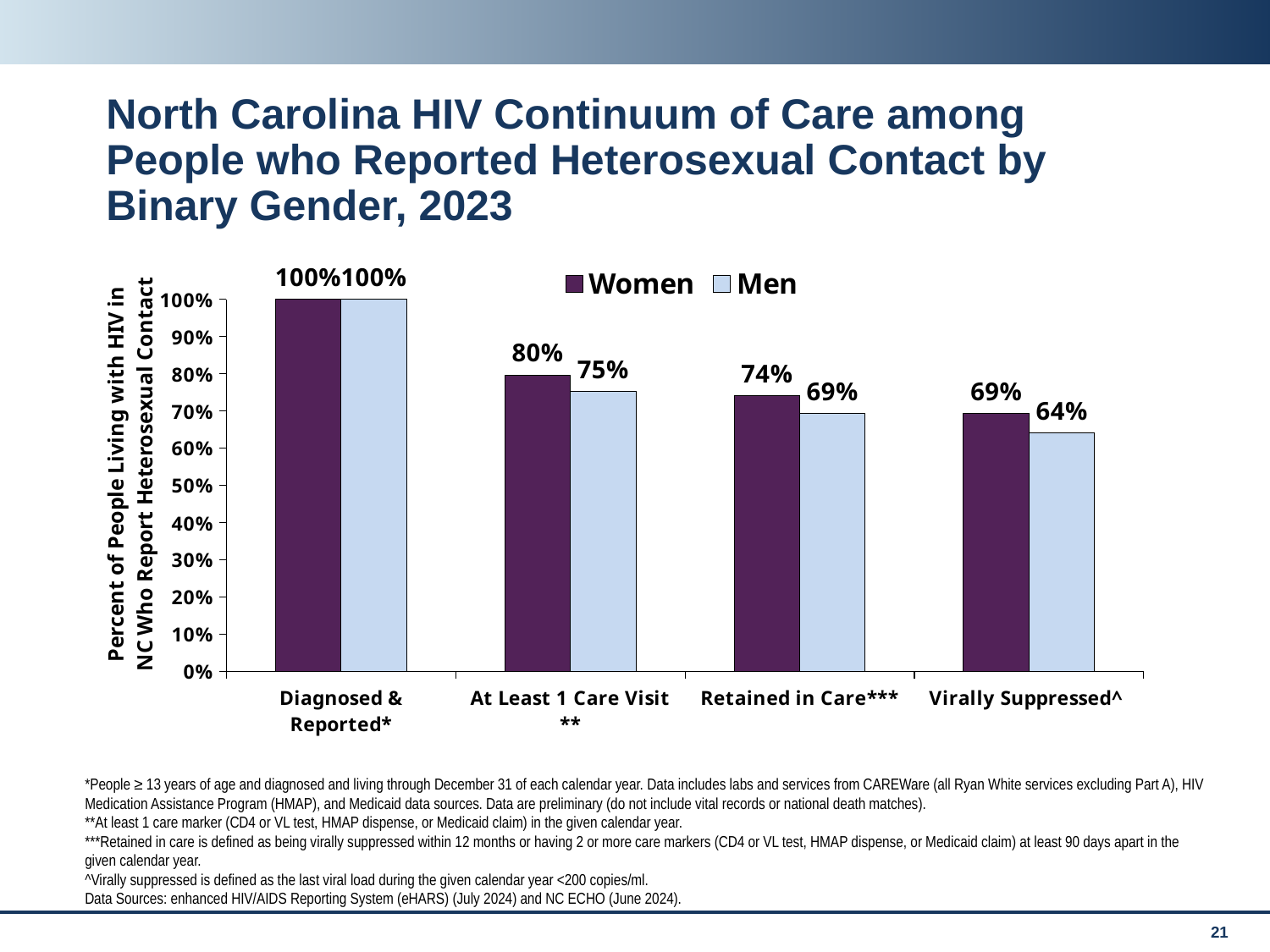
Do the values for Men rise or fall from left to right across the categories? Fall What are the two series listed in the legend? Women and Men What is the value for Women in the At Least 1 Care Visit category? 80% What kind of chart is shown on the slide? Bar chart What is the value for Men in the Virally Suppressed category? 64% Which category has the highest value for Men? Diagnosed & Reported Which category has the lowest value for Women? Virally Suppressed What is the difference between Women and Men in the Retained in Care category? 5% How many series does the legend list? 2 Which is larger: Women in At Least 1 Care Visit or Men in At Least 1 Care Visit? Women How many categories are shown on the x axis? 4 What is the value for Men in the Retained in Care category? 69%